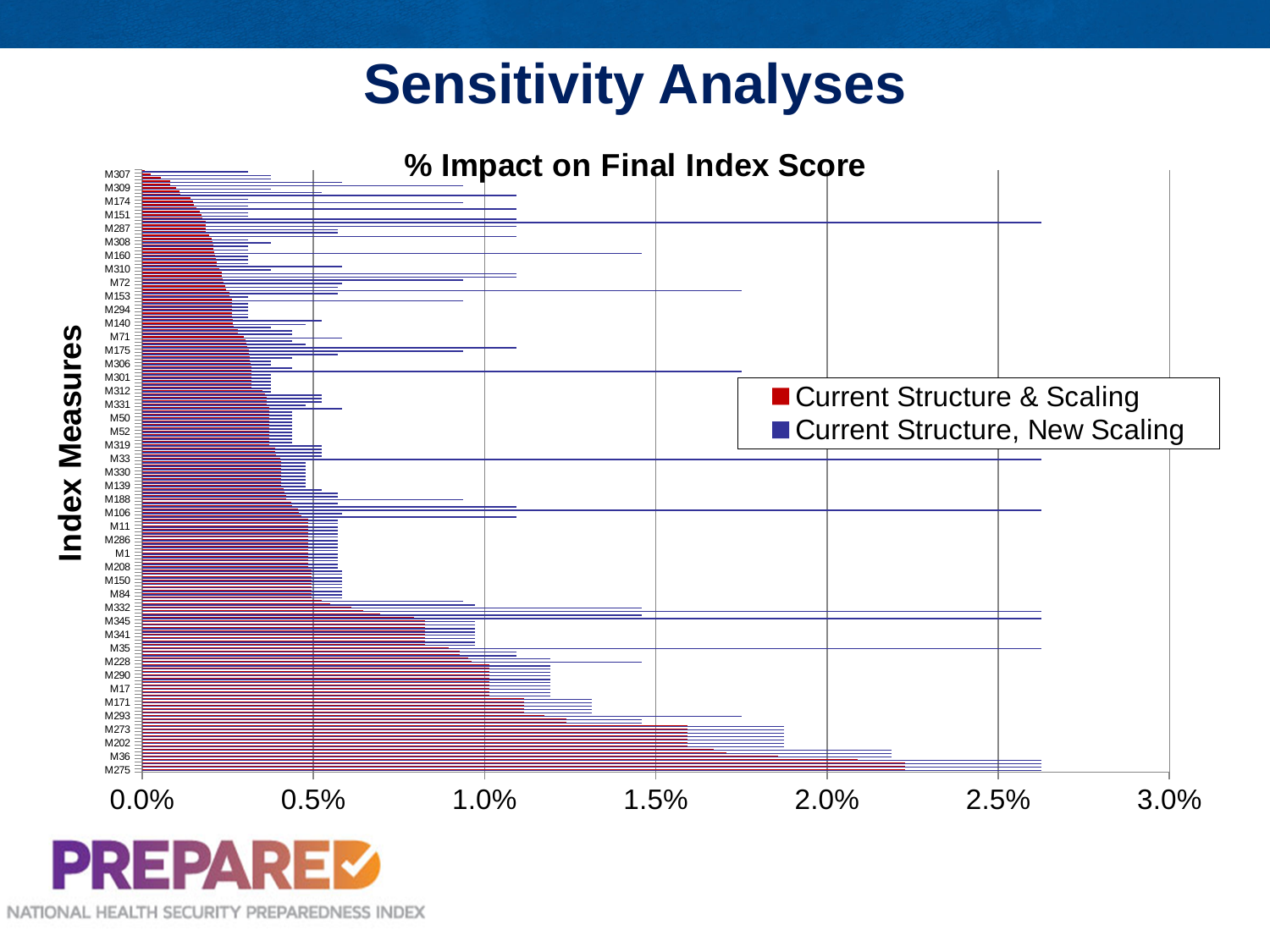
Is the value for M36 in the Current Structure, New Scaling series greater or less than 1.5%? greater What is the label on the vertical axis of the chart? Index Measures Which has the larger value in the Current Structure, New Scaling series, M275 or M307? M275 Which has the larger value in the Current Structure, New Scaling series, M36 or M84? M36 What is the title of the chart? % Impact on Final Index Score Is the value for M1 in the Current Structure, New Scaling series greater or less than 1.0%? less Is the value for M307 in the Current Structure & Scaling series greater or less than 0.5%? less How many series does the legend list? 2 What kind of chart is shown on the slide? bar chart